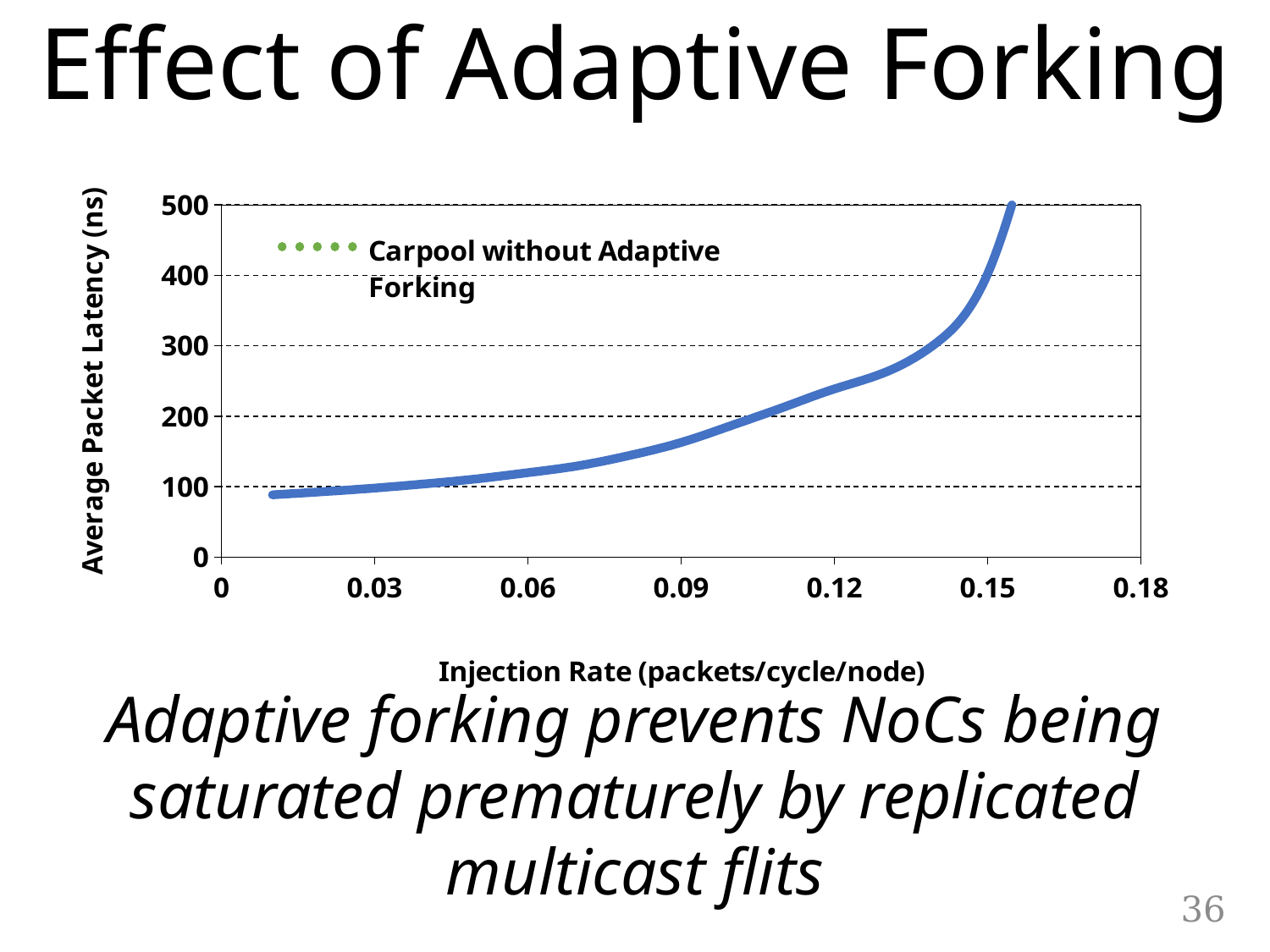
How many series does the legend list? 1 What kind of chart is shown on the slide? line chart Is the average packet latency at an injection rate of 0.12 greater or less than 200? greater What is the label of the y axis? Average Packet Latency (ns) Is the average packet latency at an injection rate of 0.09 greater or less than 200? less Is the average packet latency at an injection rate of 0.06 greater or less than 200? less What is the label of the x axis? Injection Rate (packets/cycle/node) Does the average packet latency rise or fall as the injection rate increases? rises